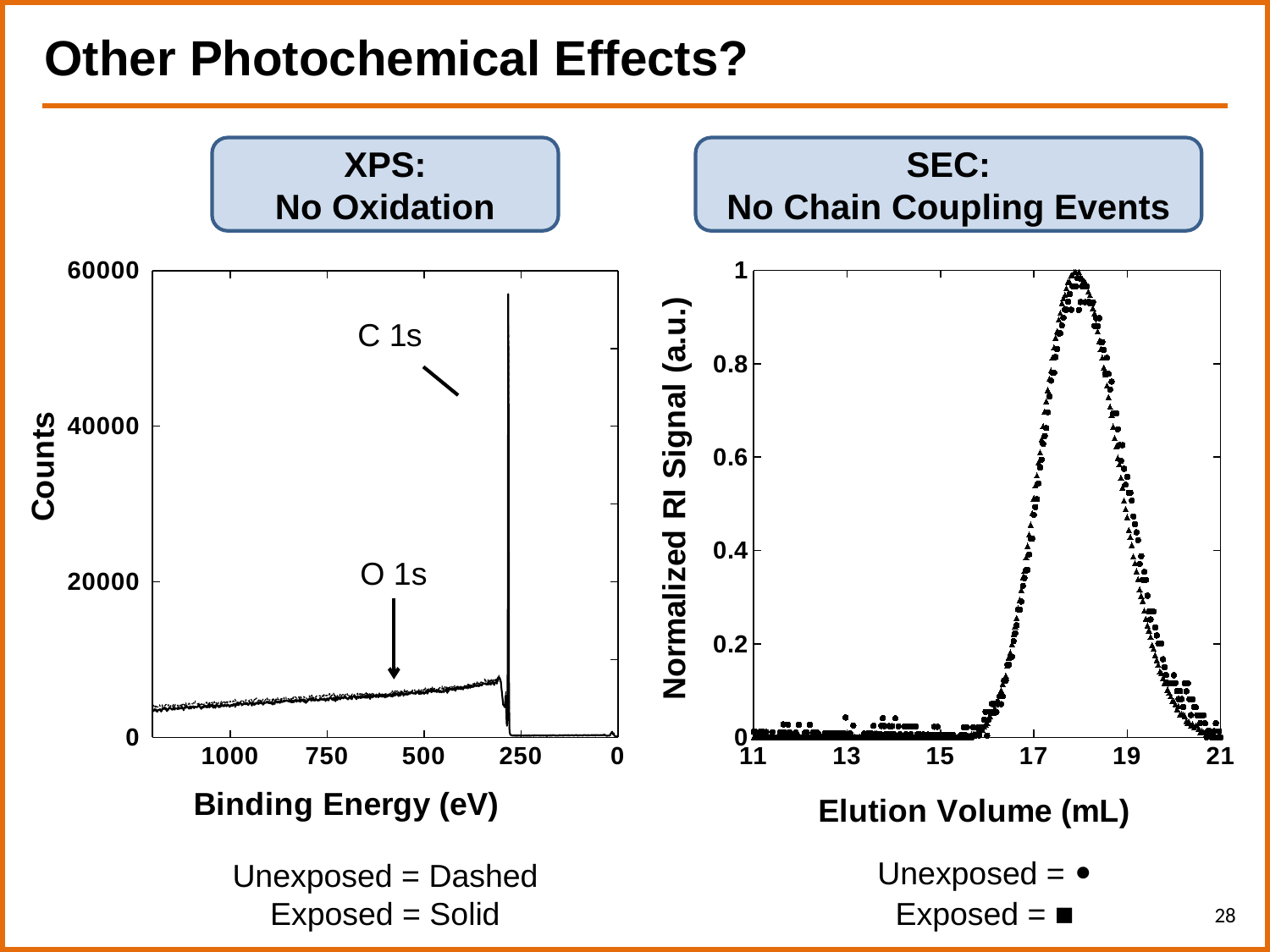
On the SEC chart on the right, what is the maximum value of the normalized RI signal? 1 On the SEC chart on the right, is the normalized RI signal at 18 mL greater or less than 0.8? greater On the XPS chart on the left, is the signal at the O 1s position (around 530 eV) greater or less than 20000 counts? less On the XPS chart on the left, which peak is higher, C 1s or O 1s? C 1s On the SEC chart on the right, is the normalized RI signal at 13 mL greater or less than 0.2? less On the XPS chart on the left, what kind of chart is it? line chart On the SEC chart on the right, what kind of chart is it? scatter chart On the XPS chart on the left, what is the label of the y axis? Counts On the XPS chart on the left, what is the label of the x axis? Binding Energy (eV) On the XPS chart on the left, how many series are plotted (unexposed and exposed)? 2 On the SEC chart on the right, how does the normalized RI signal change as elution volume increases from 15 mL to 21 mL? rises to a peak near 18 mL, then falls